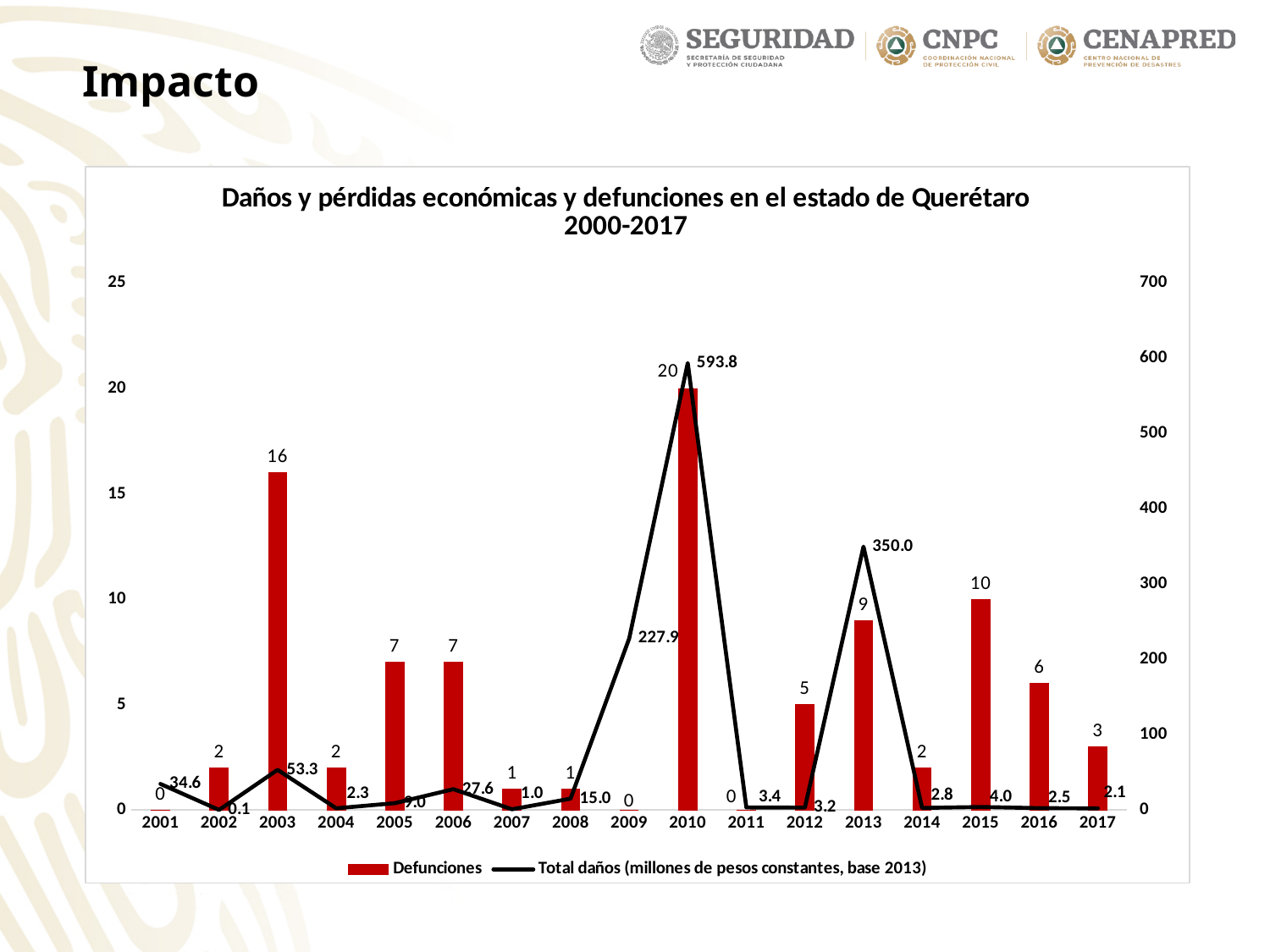
What is the value of Total daños for 2013? 350.0 How many years are shown on the x axis? 17 What kind of chart is used to show Defunciones? Bar chart Is the Total daños value for 2009 greater or less than 200? greater What is the difference in Defunciones between 2010 and 2003? 4 Which year has the highest number of Defunciones? 2010 Which year has the lowest value of Total daños? 2002 How many deaths (Defunciones) were recorded in 2003? 16 What is the value of Total daños for 2010? 593.8 How many series does the legend list? 2 Which year has more Defunciones, 2015 or 2013? 2015 What is the title of the chart? Daños y pérdidas económicas y defunciones en el estado de Querétaro 2000-2017